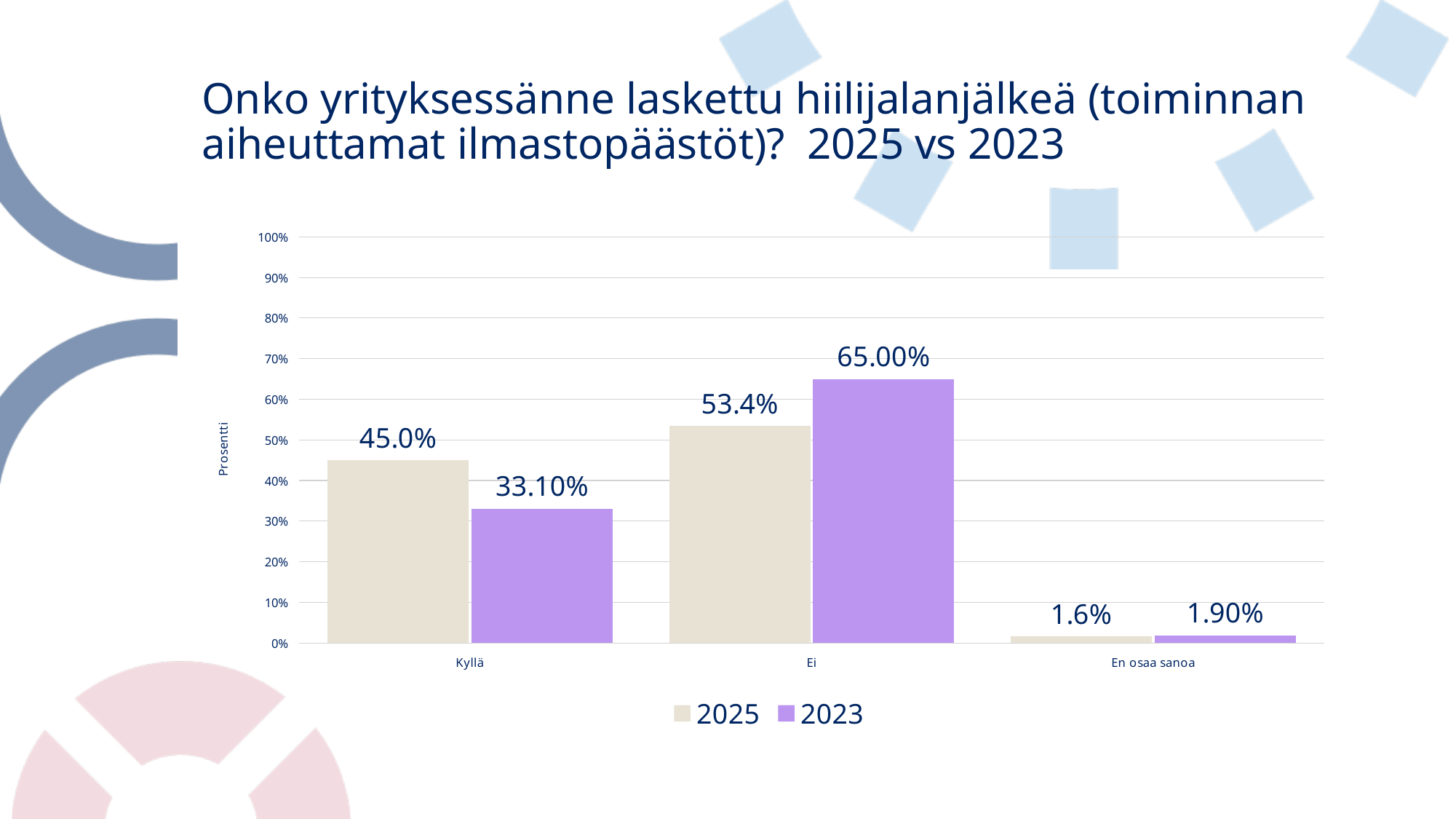
Which is larger for Kyllä: the 2025 value or the 2023 value? 2025 How many series does the legend list? 2 What is the value for Ei in the 2023 series? 65.00% What is the value for En osaa sanoa in the 2025 series? 1.6% What is the label of the y axis? Prosentti What is the value for Kyllä in the 2025 series? 45.0% What is the difference between the 2023 and 2025 values for Ei? 11.6% Which category has the highest value in the 2023 series? Ei What is the value for Kyllä in the 2023 series? 33.10% How many categories are shown on the x axis? 3 What kind of chart is shown on the slide? Bar chart Which category has the lowest value in the 2025 series? En osaa sanoa